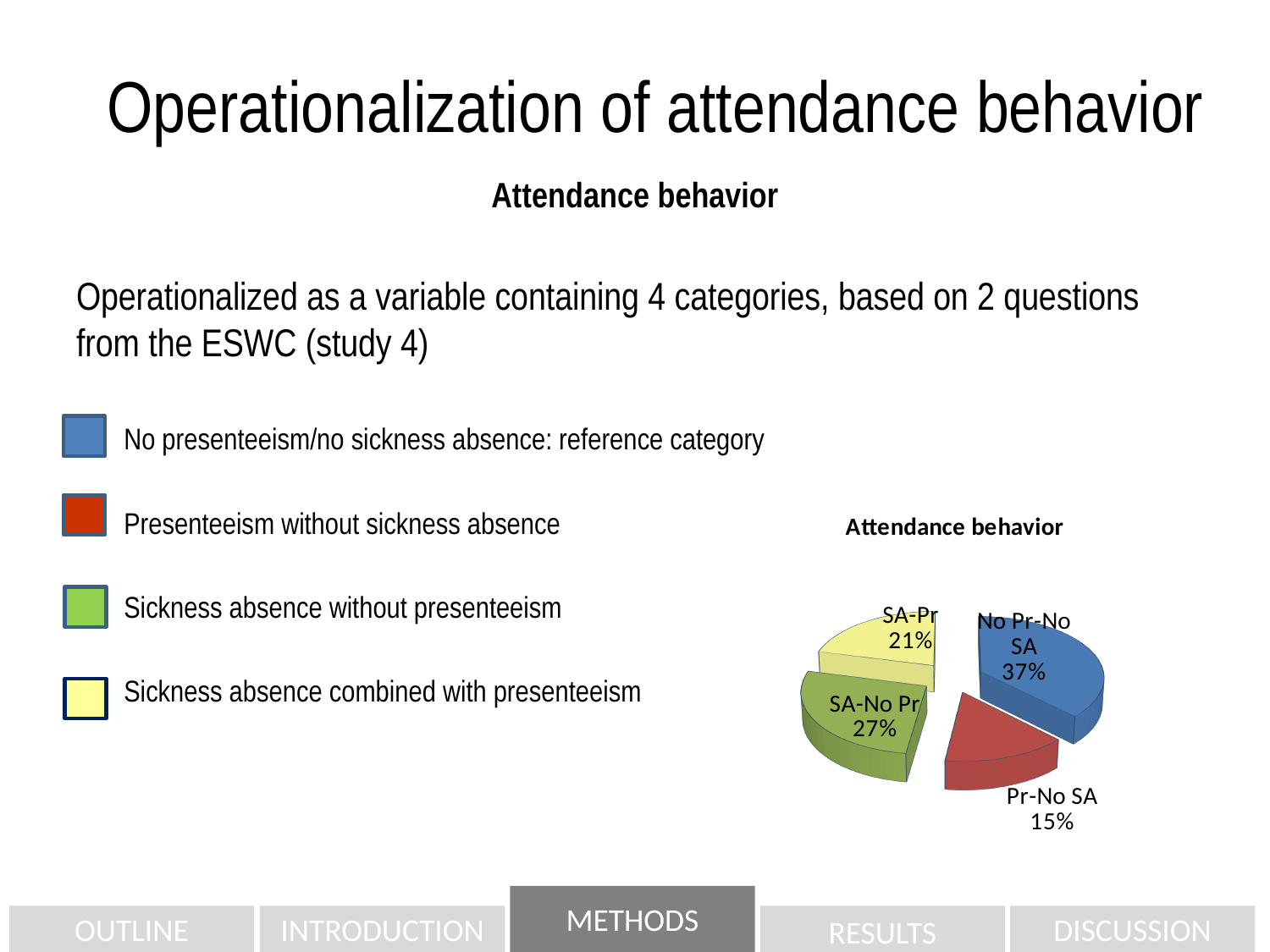
How many slices does the pie chart have? 4 What percentage is shown for the SA-Pr slice? 21% What is the title of the chart? Attendance behavior What is the difference in percentage points between the No Pr-No SA slice and the Pr-No SA slice? 22 Which slice of the pie chart is the smallest? Pr-No SA Which slice of the pie chart is the largest? No Pr-No SA What percentage is shown for the SA-No Pr slice? 27% What percentage is shown for the Pr-No SA slice? 15% What type of chart is shown on the slide? Pie chart What percentage is shown for the No Pr-No SA slice? 37% What colour is the No Pr-No SA slice? Blue Which is larger, the SA-No Pr slice or the SA-Pr slice? SA-No Pr